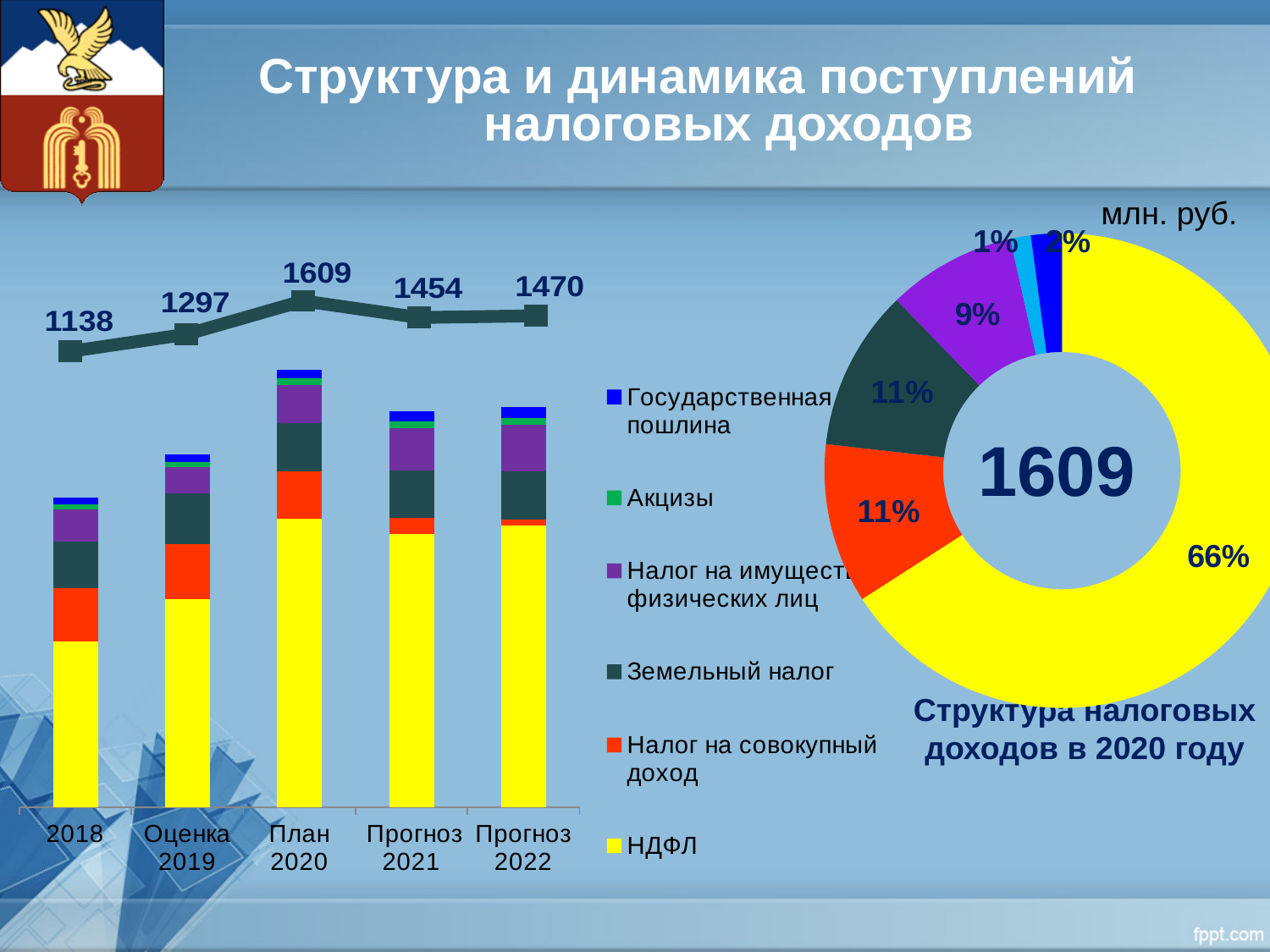
On the left bar chart, what is the total value shown for 2018? 1138 On the doughnut chart 'Структура налоговых доходов в 2020 году', what share does НДФЛ have? 66% On the left bar chart, which period has the highest total value? План 2020 What value is shown in the centre of the doughnut chart 'Структура налоговых доходов в 2020 году'? 1609 On the left bar chart, how many periods are shown on the x axis? 5 On the left bar chart, which total is larger: Прогноз 2021 or Прогноз 2022? Прогноз 2022 On the left bar chart, do the totals rise or fall from 2018 to План 2020? rise On the left bar chart, what is the total tax revenue value shown for План 2020? 1609 On the left bar chart, what is the difference between the totals for Прогноз 2022 and Прогноз 2021? 16 How many series does the legend list? 6 On the left bar chart, which period has the lowest total value? 2018 On the left bar chart, what is the difference between the totals for План 2020 and 2018? 471